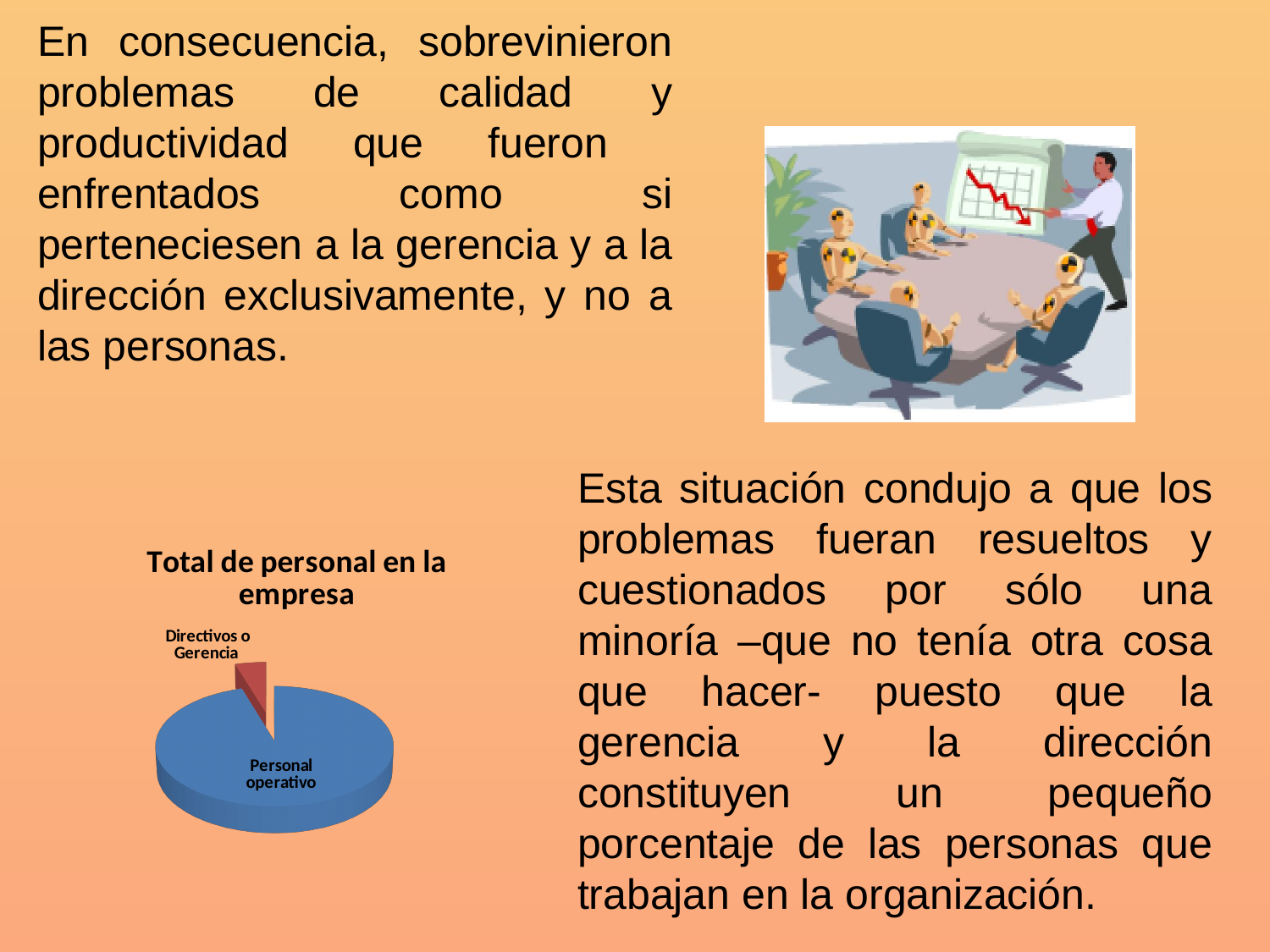
What kind of chart is shown on the slide? pie chart Is the slice for Directivos o Gerencia greater or less than half of the pie? less Which slice is larger, Directivos o Gerencia or Personal operativo? Personal operativo Is the slice for Personal operativo greater or less than half of the pie? greater How many slices does the pie chart have? 2 Which category has the largest slice of the pie? Personal operativo Which category has the smallest slice of the pie? Directivos o Gerencia What colour is the slice for Personal operativo? blue What is the title of the chart? Total de personal en la empresa